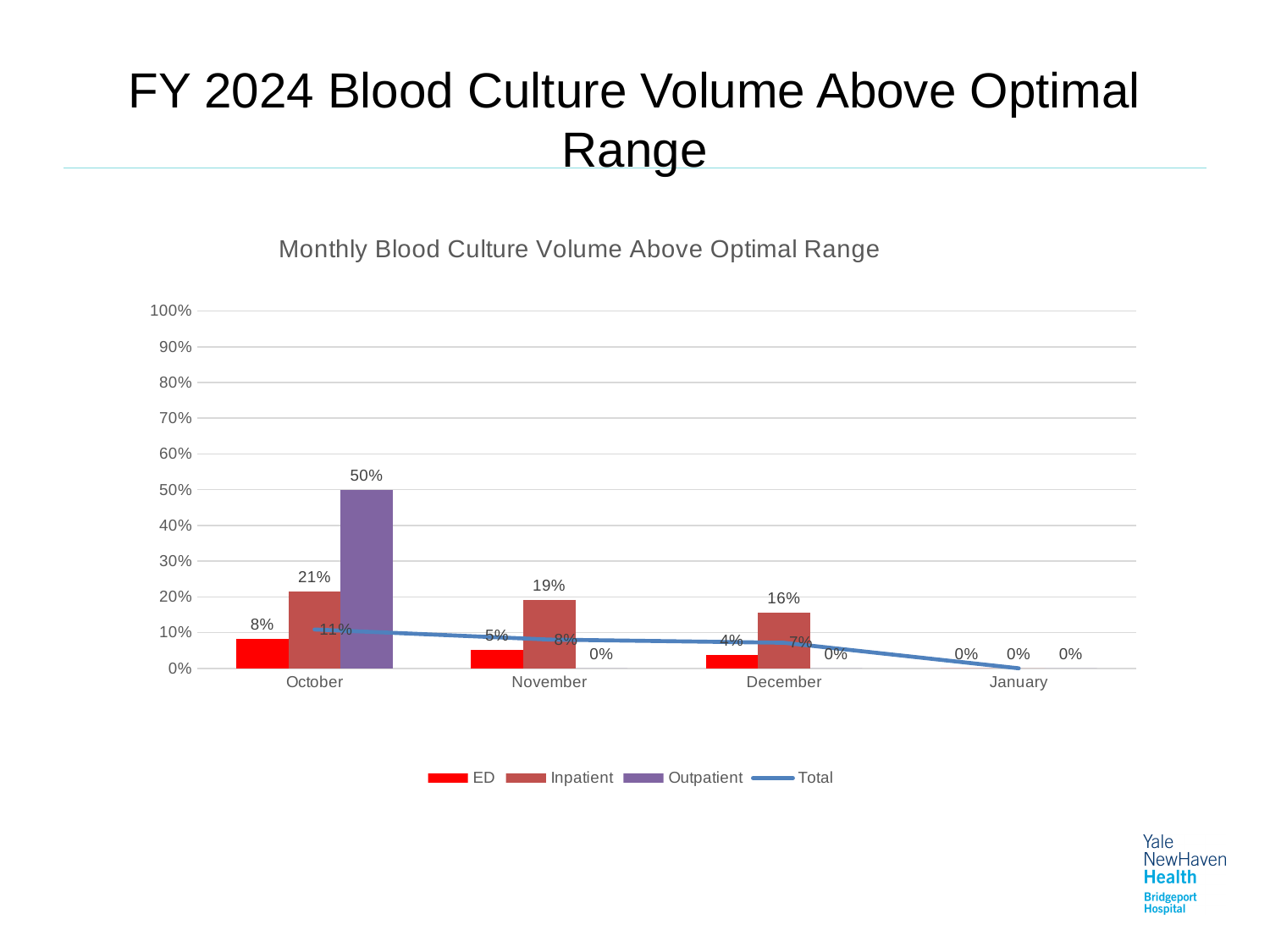
What is the ED value for December? 4% What is the Outpatient value for October? 50% Which is larger, the ED value for October or the ED value for November? October What is the difference between the Inpatient values for October and December? 5% What is the Inpatient value for November? 19% How many series does the legend list? 4 What is the Total value for October? 11% Is the Outpatient value for October greater or less than 40%? greater Which month has the lowest Total value? January How many months are shown on the x axis? 4 Which month has the highest Inpatient value? October Does the Total line rise or fall from October to January? fall